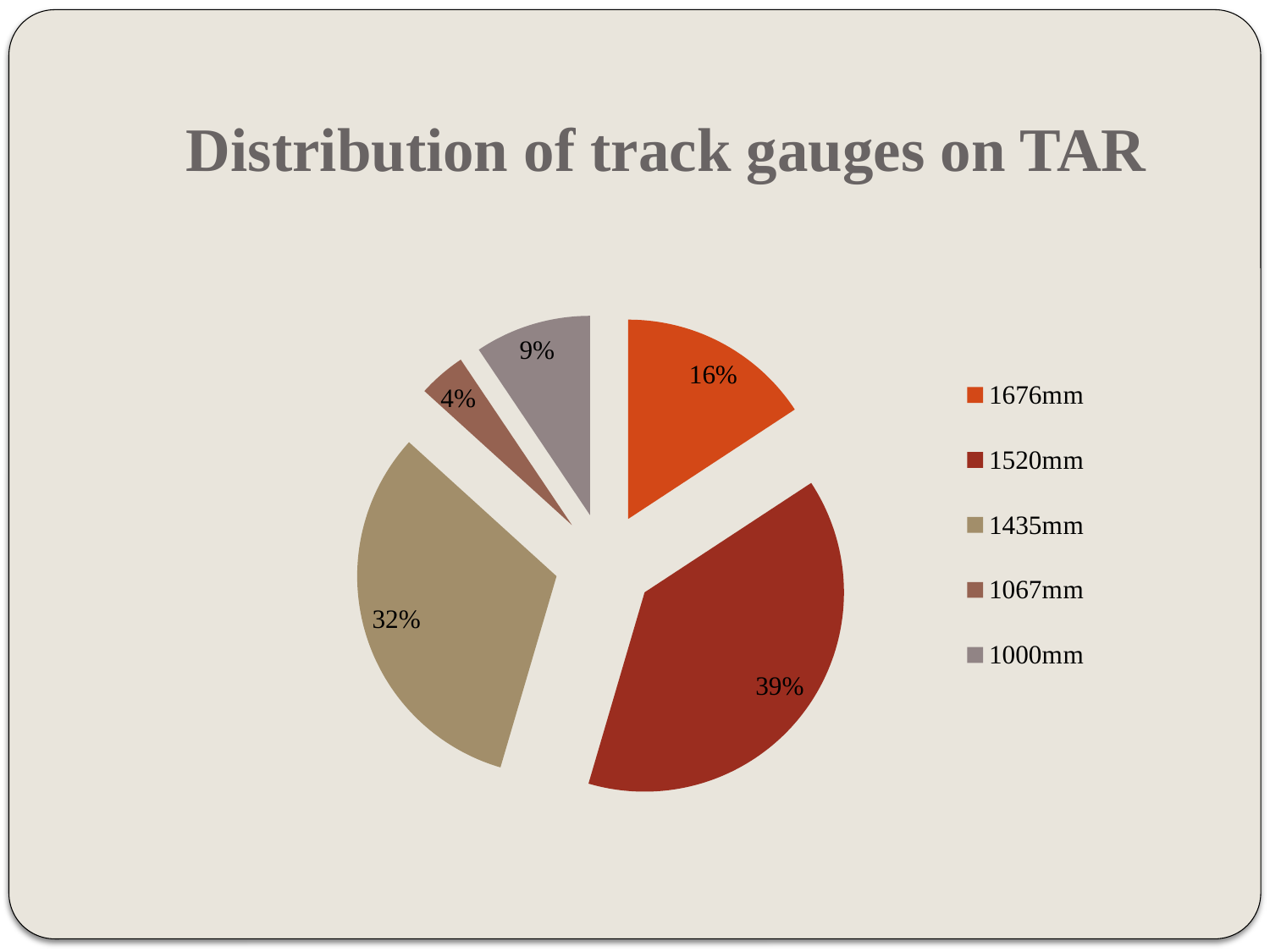
What is the value shown for the 1067mm slice? 4% Which has a larger share, the 1676mm gauge or the 1000mm gauge? 1676mm What is the title of the chart? Distribution of track gauges on TAR What kind of chart is shown on the slide? Pie chart Which track gauge has the largest share of the pie? 1520mm What share of the pie does the 1435mm track gauge represent? 32% What is the value shown for the 1000mm slice? 9% What share of the pie does the 1520mm track gauge represent? 39% How many track gauge categories are shown in the pie chart? 5 Which track gauge has the smallest share of the pie? 1067mm What is the difference between the shares of the 1520mm and 1435mm gauges? 7% What is the value shown for the 1676mm slice? 16%